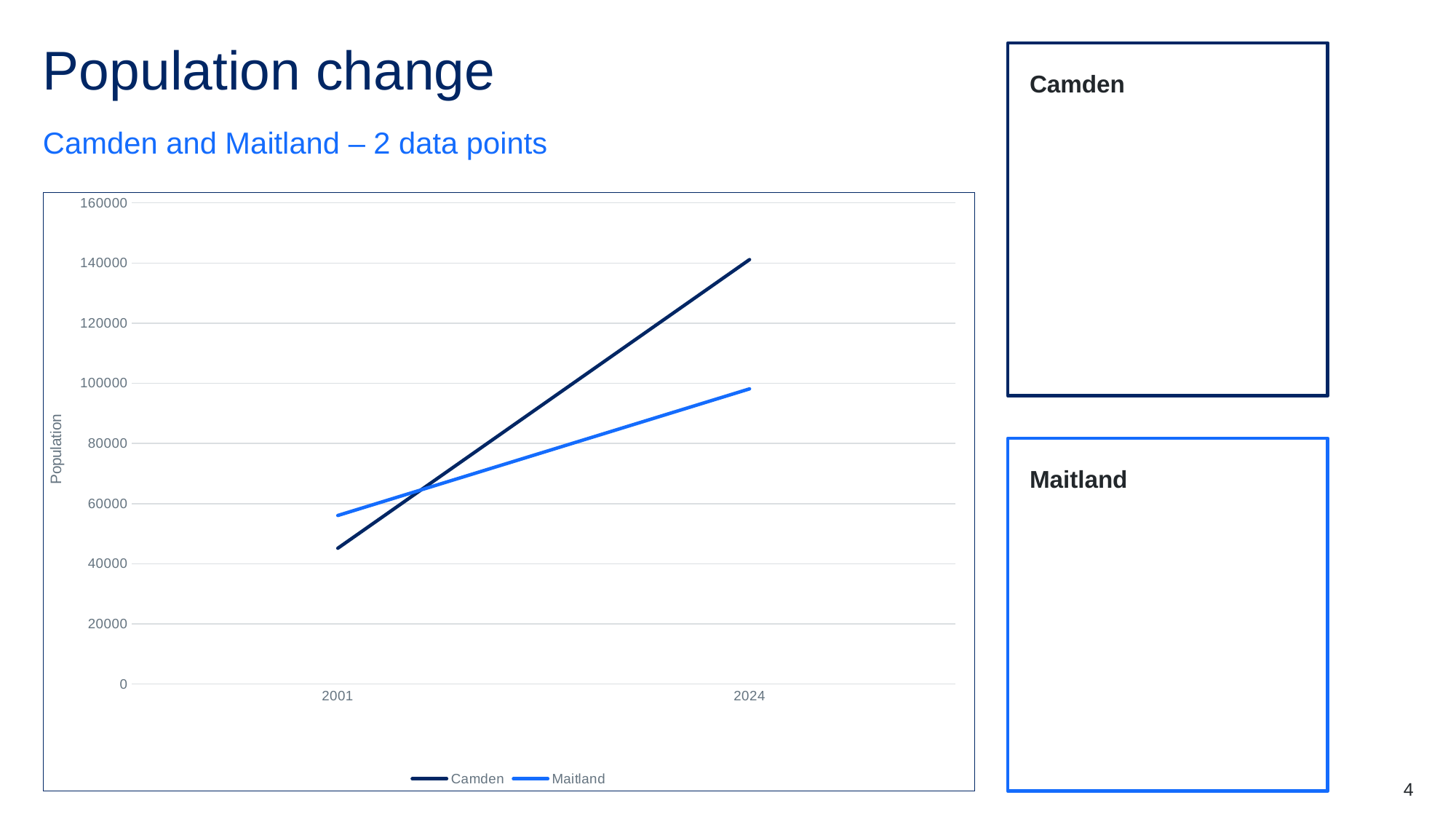
Is the value for Camden in 2024 greater or less than 120000? greater Is the value for Maitland in 2001 greater or less than 40000? greater Which series has the higher population in 2024, Camden or Maitland? Camden What kind of chart is shown on the slide? line chart Is the value for Maitland in 2024 greater or less than 80000? greater How many points are on the x axis of the chart? 2 Which series has the higher population in 2001, Camden or Maitland? Maitland How many series does the chart legend list? 2 Does the Maitland line rise or fall from 2001 to 2024? rise Does the Camden line rise or fall from 2001 to 2024? rise What is the label on the y axis of the chart? Population